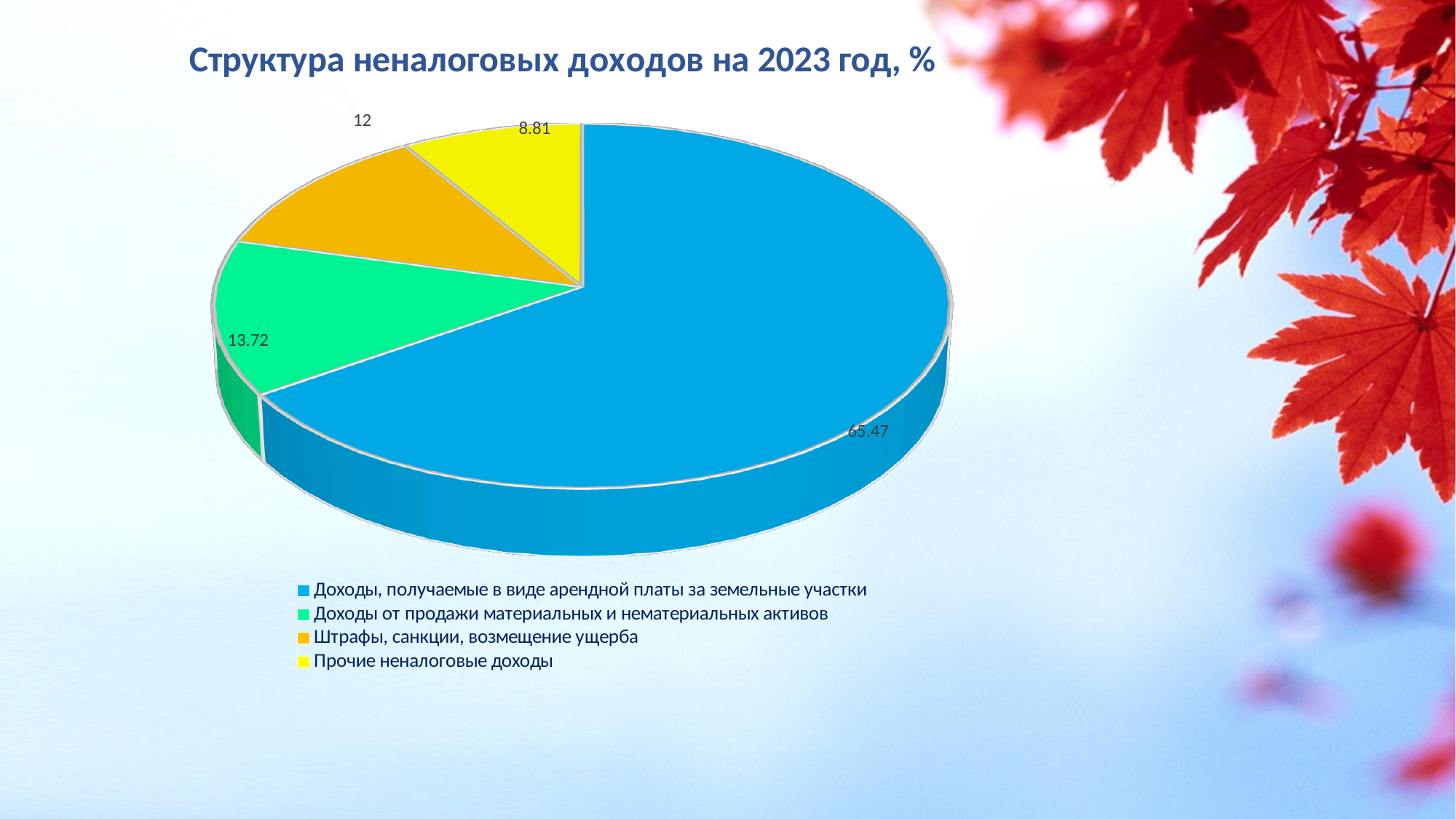
What type of chart is shown on the slide? Pie chart What is the title of the chart? Структура неналоговых доходов на 2023 год, % Which category has the smallest share of the pie? Прочие неналоговые доходы Which is larger: the value for "Штрафы, санкции, возмещение ущерба" or the value for "Прочие неналоговые доходы"? Штрафы, санкции, возмещение ущерба What colour is the slice for "Прочие неналоговые доходы"? Yellow How many categories does the pie chart have? 4 What is the value for "Доходы, получаемые в виде арендной платы за земельные участки"? 65.47 What is the value for "Доходы от продажи материальных и нематериальных активов"? 13.72 What is the difference between the values for "Доходы от продажи материальных и нематериальных активов" and "Штрафы, санкции, возмещение ущерба"? 1.72 What is the value for "Штрафы, санкции, возмещение ущерба"? 12 What is the value for "Прочие неналоговые доходы"? 8.81 Which category has the largest share of the pie? Доходы, получаемые в виде арендной платы за земельные участки